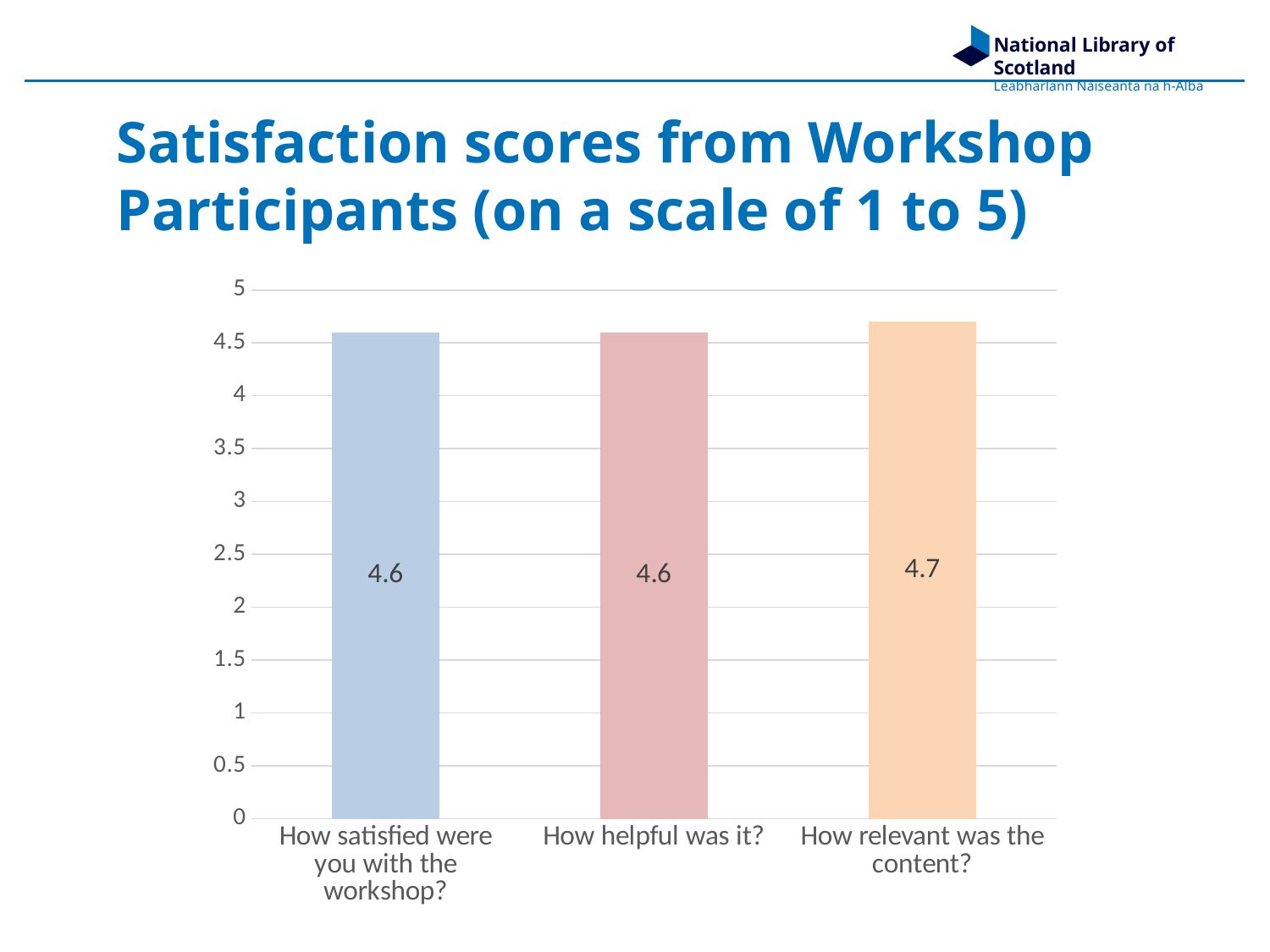
What is the score for "How relevant was the content?"? 4.7 What kind of chart is shown on the slide? Bar chart What is the difference between the score for "How relevant was the content?" and the score for "How helpful was it?"? 0.1 Is the score for "How satisfied were you with the workshop?" greater or less than 4? greater How many categories are shown on the chart? 3 What is the maximum value shown on the vertical axis? 5 Which question received the highest score? How relevant was the content? What is the score for "How helpful was it?"? 4.6 What is the score for "How satisfied were you with the workshop?"? 4.6 What is the title of the slide? Satisfaction scores from Workshop Participants (on a scale of 1 to 5) Is the score for "How relevant was the content?" greater or less than 4.5? greater